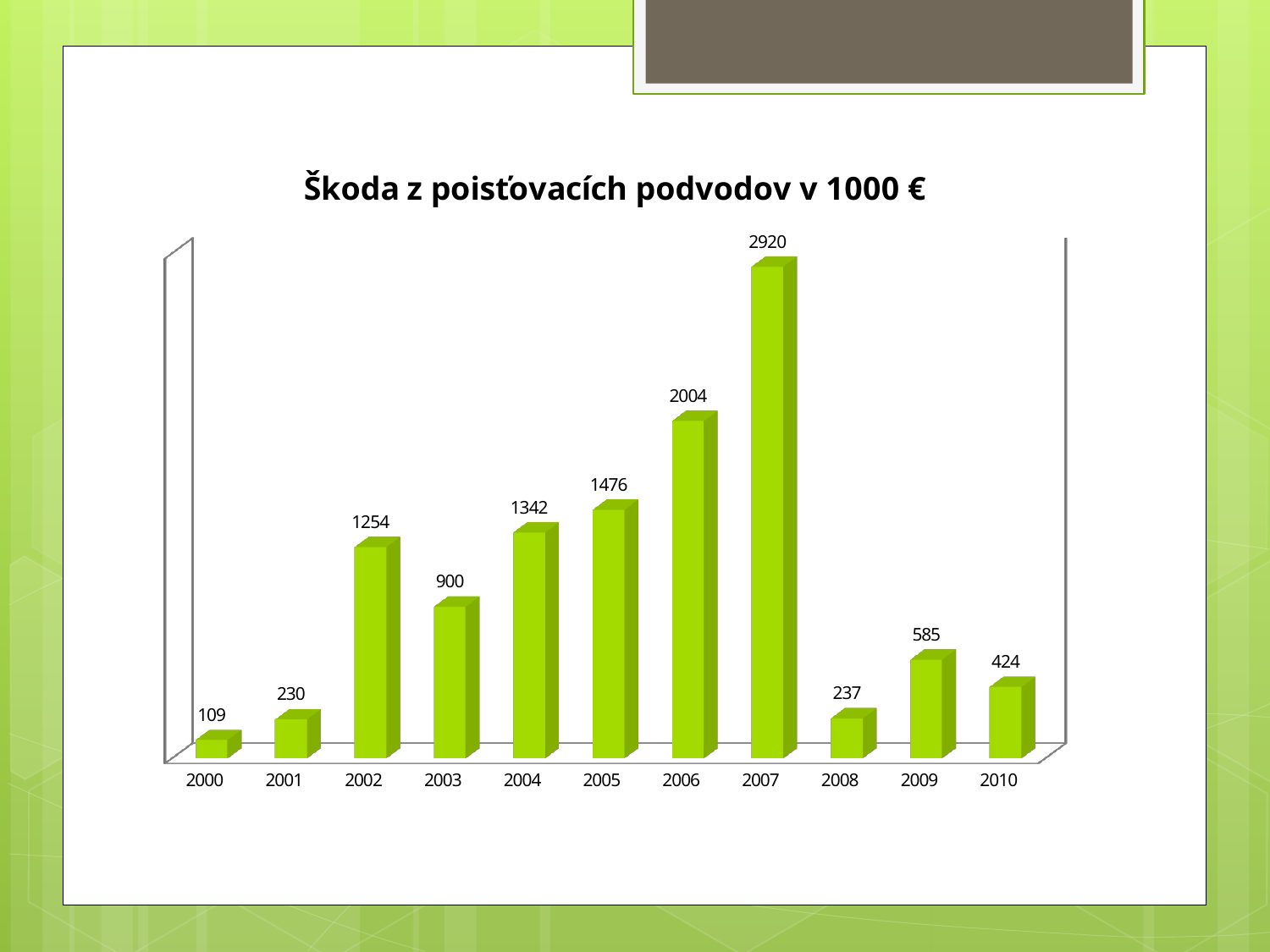
Do the values rise or fall from 2003 to 2007? Rise What is the value for 2007? 2920 Which is larger, the value for 2002 or the value for 2004? 2004 What is the difference between the values for 2009 and 2008? 348 What is the difference between the values for 2007 and 2006? 916 What kind of chart is shown on the slide? Bar chart How many years are shown on the x axis? 11 Which year has the lowest value? 2000 What is the value for 2003? 900 What is the title of the chart? Škoda z poisťovacích podvodov v 1000 € What is the value for 2010? 424 Which year has the highest value? 2007